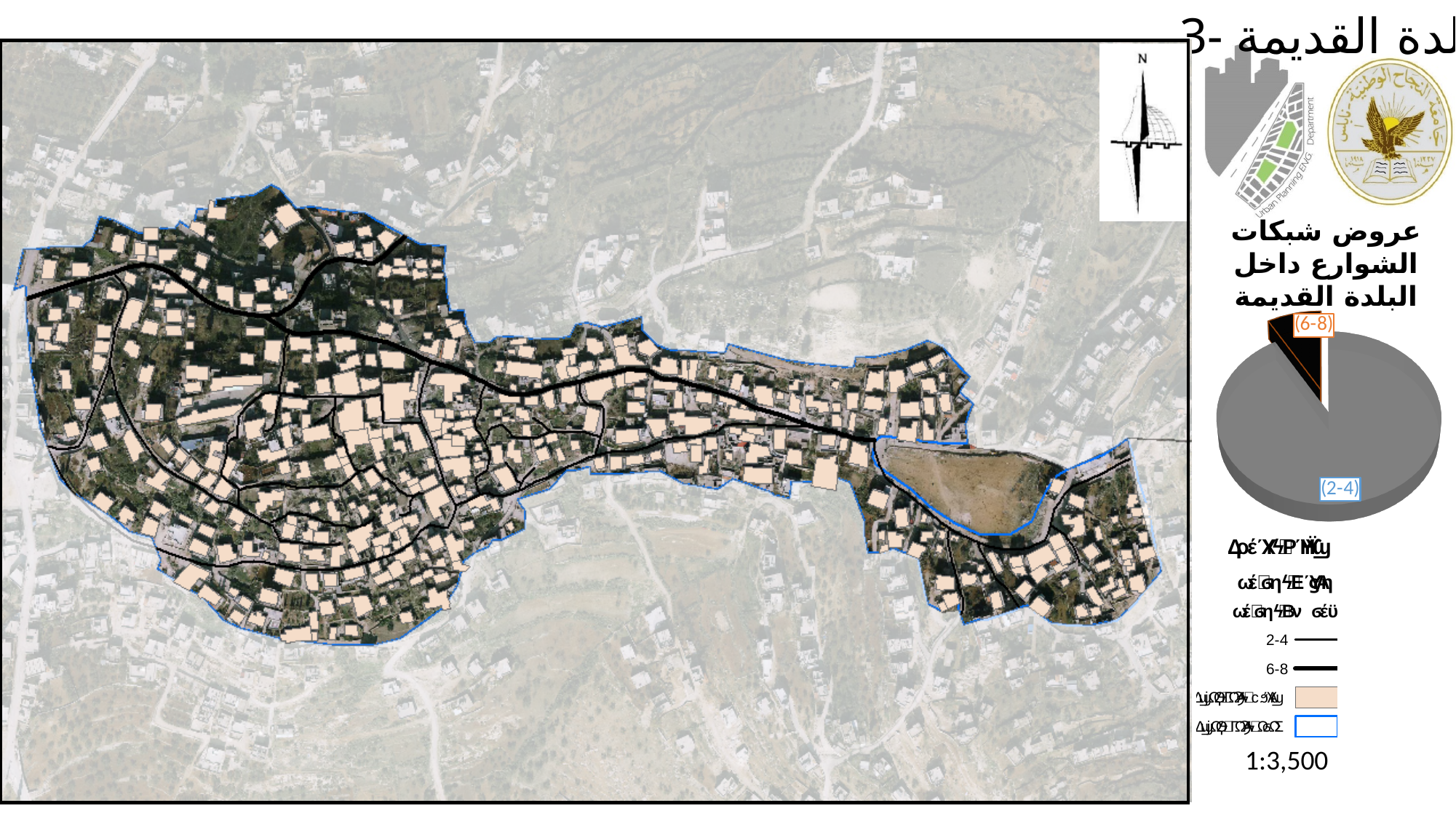
In the pie chart, which slice is larger, (2-4) or (6-8)? (2-4) What are the labels of the two slices in the pie chart? (6-8) and (2-4) Does the (6-8) slice take up more or less than half of the pie chart? less Which slice of the pie chart is the smallest? (6-8) What kind of chart is shown on the right side of the slide? pie chart Does the (2-4) slice take up more or less than half of the pie chart? more How many slices does the pie chart have? 2 Which slice of the pie chart is the largest? (2-4) What is the title written above the pie chart? عروض شبكات الشوارع داخل البلدة القديمة